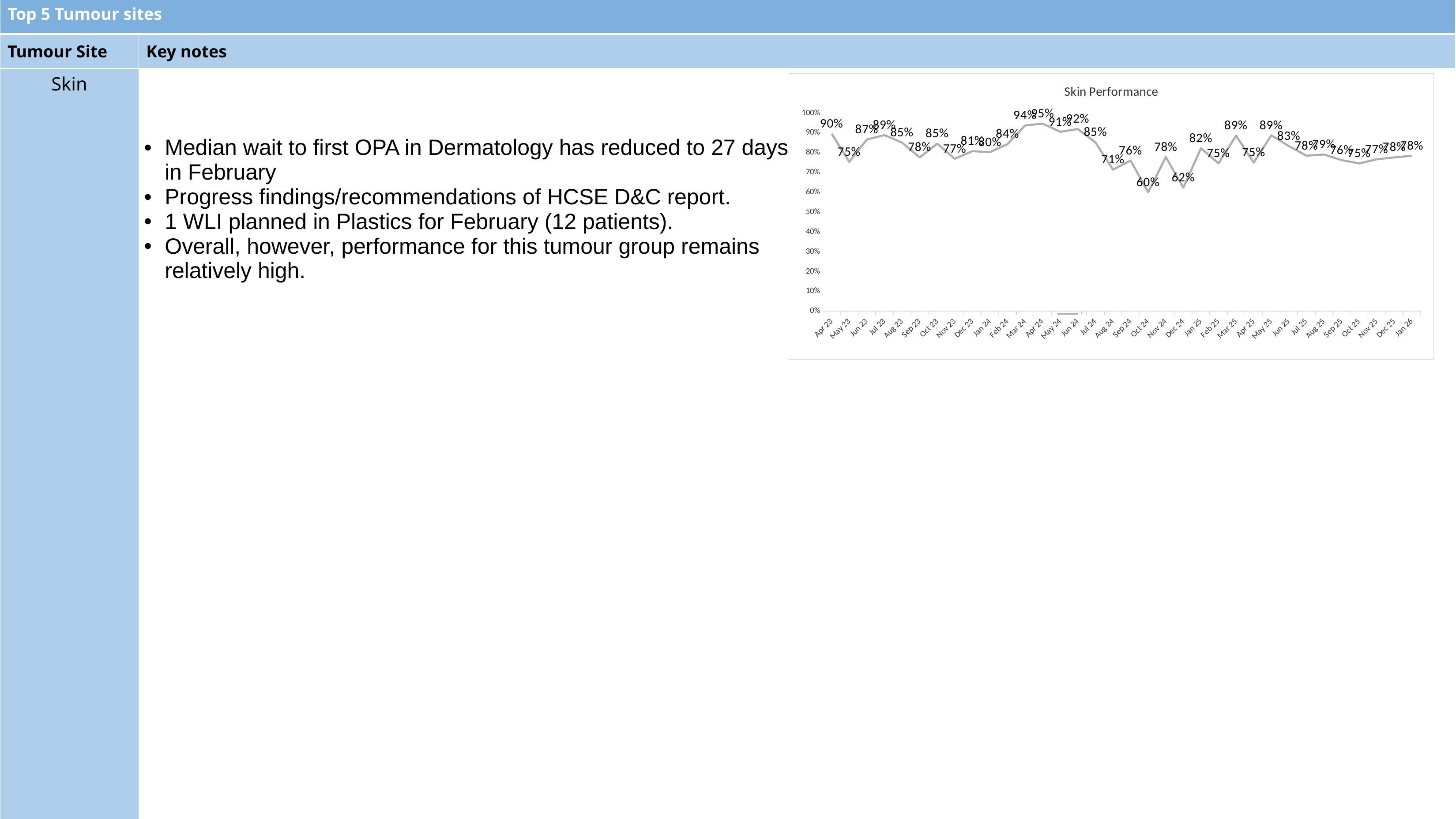
Is the value for Oct 24 in the Skin Performance chart greater or less than 70%? less What is the value for Dec 24 in the Skin Performance chart? 62% In the Skin Performance chart, which month has the lowest value? Oct 24 What is the title of the chart on the slide? Skin Performance In the Skin Performance chart, which is larger: the value for Mar 24 or the value for Aug 24? Mar 24 How many monthly data points are plotted in the Skin Performance chart? 34 What is the difference between the highest value (Apr 24) and the lowest value (Oct 24) in the Skin Performance chart? 35 percentage points What is the value for Apr 24 in the Skin Performance chart? 95% What is the value for Oct 24 in the Skin Performance chart? 60% In the Skin Performance chart, which month has the highest value? Apr 24 What kind of chart is the Skin Performance chart? line chart What is the value for Apr 23, the first point in the Skin Performance chart? 90%